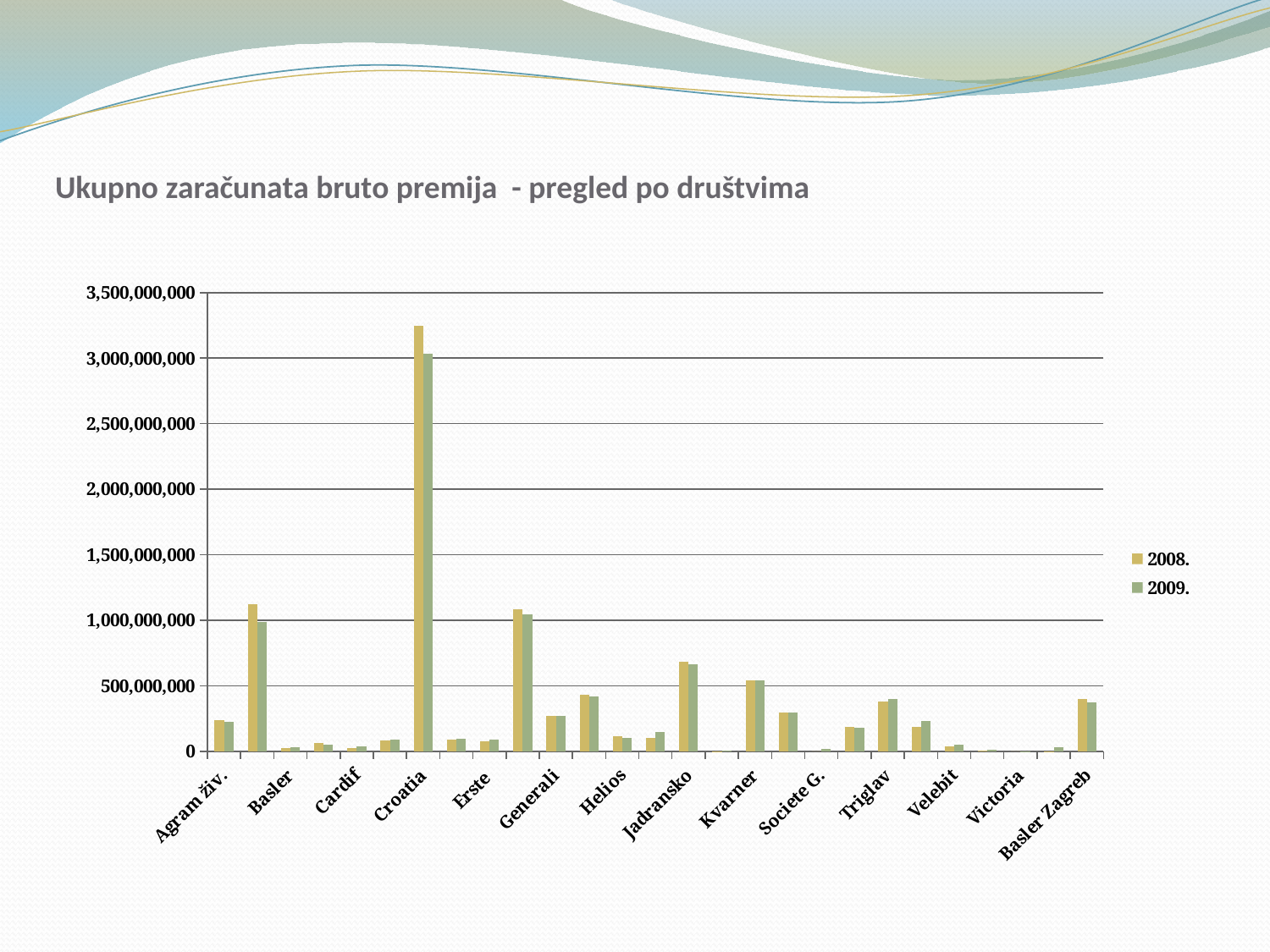
Which series are listed in the legend? 2008. and 2009. In 2008, which has the larger value, Jadransko or Kvarner? Jadransko For Croatia, which year has the larger value, 2008 or 2009? 2008 Is the 2008 value for Croatia greater or less than 3,000,000,000? greater Which company has the highest value in 2009? Croatia How many series does the legend list? 2 Is the 2008 value for Agram živ. greater or less than 500,000,000? less Is the 2008 value for Jadransko greater or less than 500,000,000? greater What kind of chart is shown on the slide? bar chart What is the title of the slide? Ukupno zaračunata bruto premija - pregled po društvima Which company has the highest value in 2008? Croatia